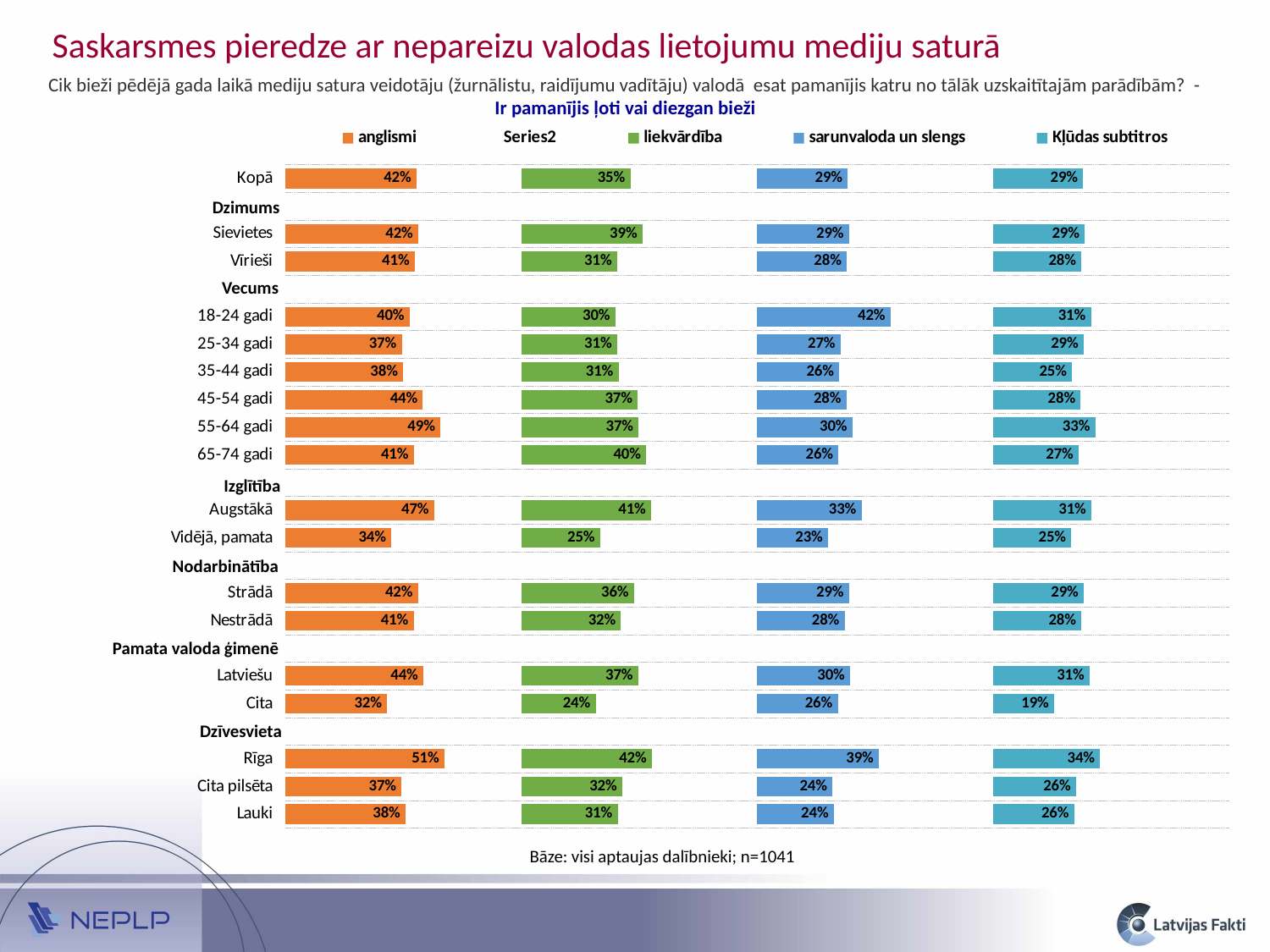
Which is larger: the liekvārdība value for Sievietes or for Vīrieši? Sievietes Which category has the highest value in the anglismi series? Rīga What is the difference between the sarunvaloda un slengs values for 18-24 gadi and 25-34 gadi? 15% What is the difference between the anglismi values for Rīga and Lauki? 13% Which category has the lowest value in the Kļūdas subtitros series? Cita Which is larger: the anglismi value for Augstākā or for Vidējā, pamata? Augstākā What is the value for Rīga in the sarunvaloda un slengs series? 39% What is the value for 65-74 gadi in the liekvārdība series? 40% What kind of chart is shown on the slide? Bar chart What is the value for Cita in the Kļūdas subtitros series? 19% What is the value for Kopā in the anglismi series? 42% Which category has the lowest value in the liekvārdība series? Cita